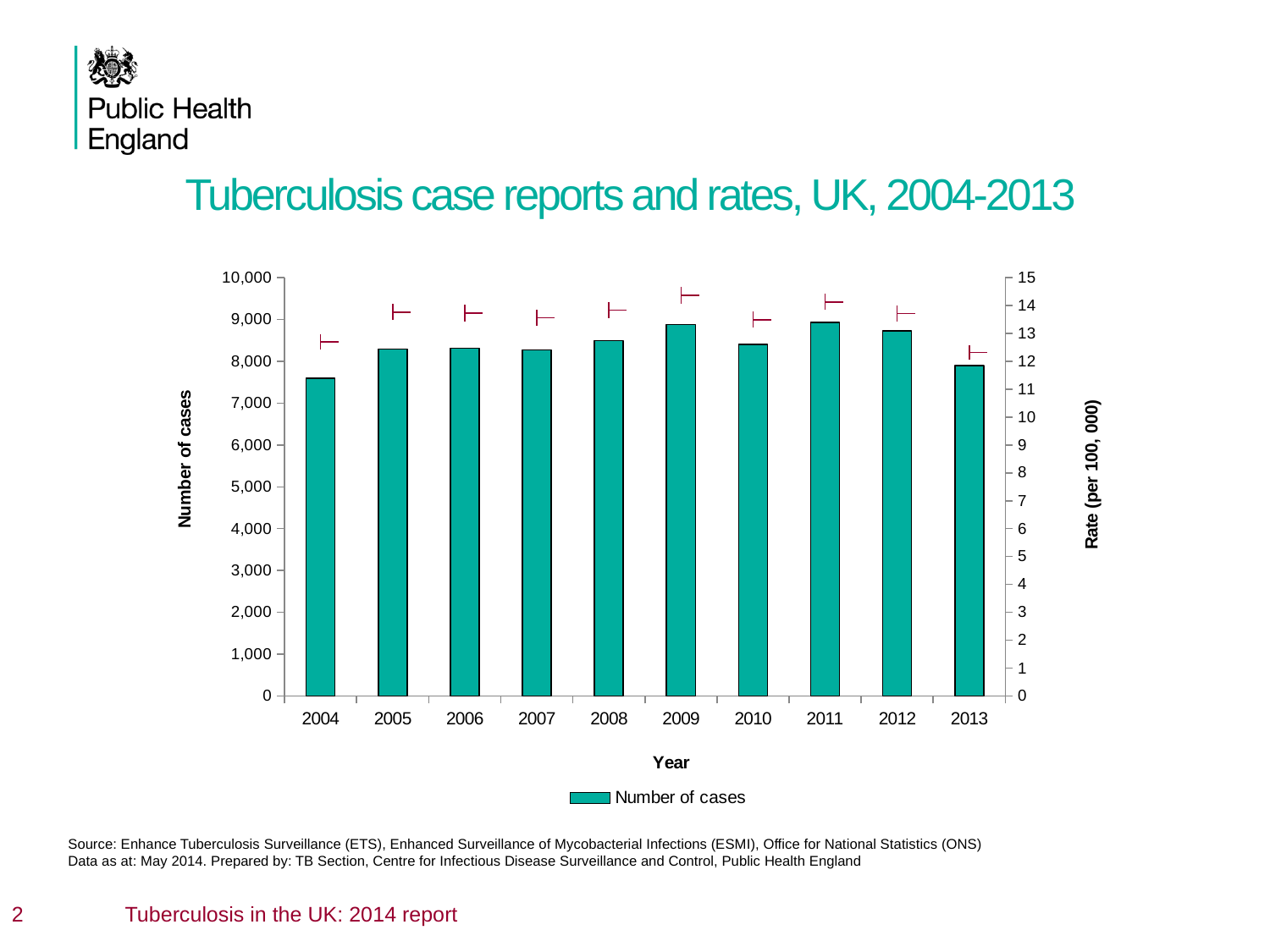
What kind of chart is shown on the slide? Bar chart How many years are shown on the x axis of the chart? 10 Which year has more cases, 2004 or 2009? 2009 What is the label of the right-hand (secondary) y axis? Rate (per 100, 000) Is the number of cases for 2004 greater or less than 8,000? less Which year has the lowest number of cases? 2004 Which year has more cases, 2010 or 2011? 2011 How many series does the chart legend list? 1 Does the number of cases rise or fall from 2011 to 2013? Fall What is the title of the chart? Tuberculosis case reports and rates, UK, 2004-2013 Is the number of cases for 2009 greater or less than 8,000? greater